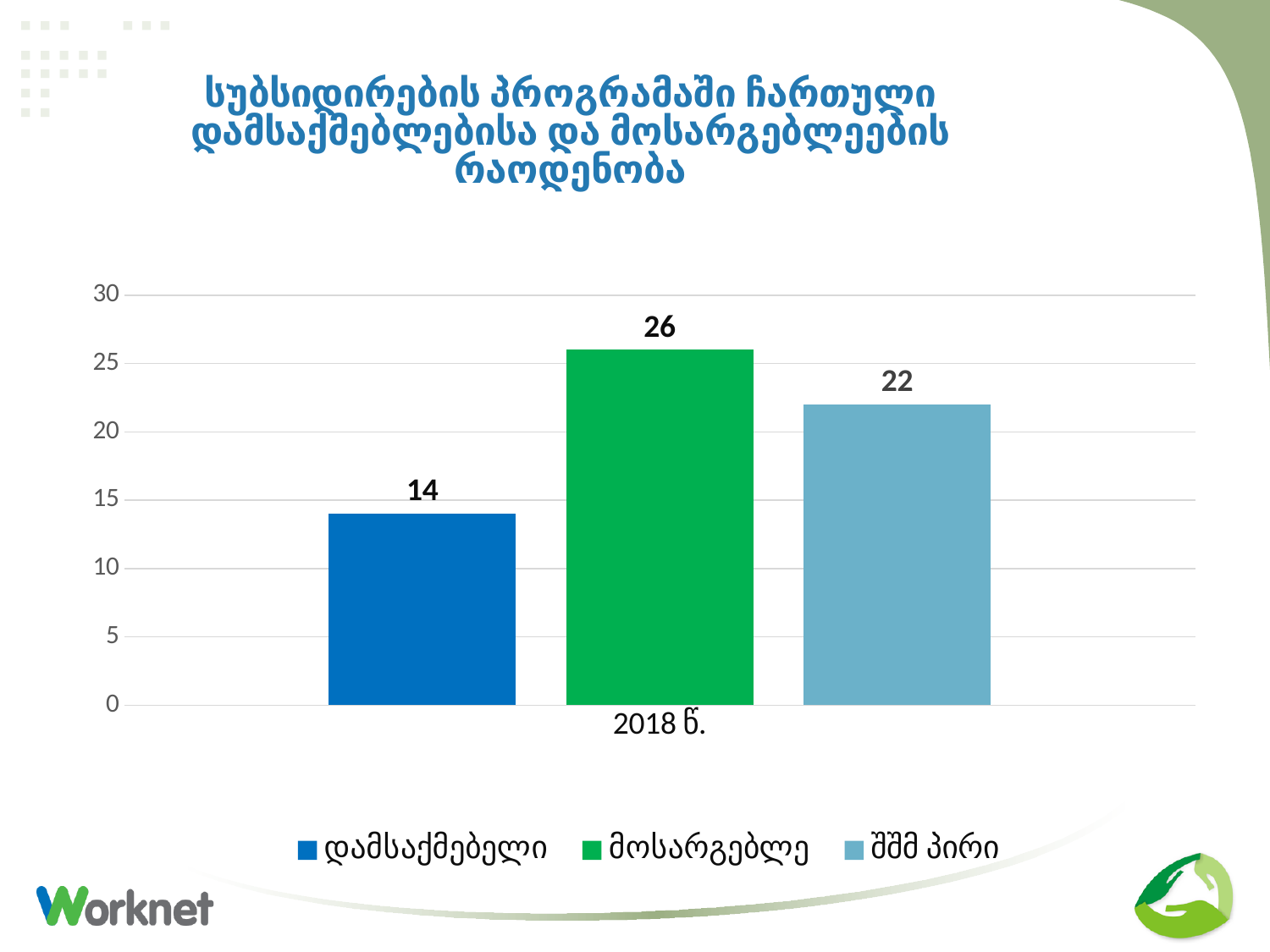
Which series has the lowest value in 2018 წ.? დამსაქმებელი What is the category label shown on the x axis? 2018 წ. What is the difference between the values for მოსარგებლე and შშმ პირი? 4 What is the value for შშმ პირი in 2018 წ.? 22 What is the difference between the values for მოსარგებლე and დამსაქმებელი? 12 Is the value for შშმ პირი greater or less than 20? greater What is the value for დამსაქმებელი in 2018 წ.? 14 How many series does the legend list? 3 Which is larger, the value for შშმ პირი or the value for დამსაქმებელი? შშმ პირი Which series has the highest value in 2018 წ.? მოსარგებლე What is the value for მოსარგებლე in 2018 წ.? 26 What kind of chart is shown on the slide? bar chart